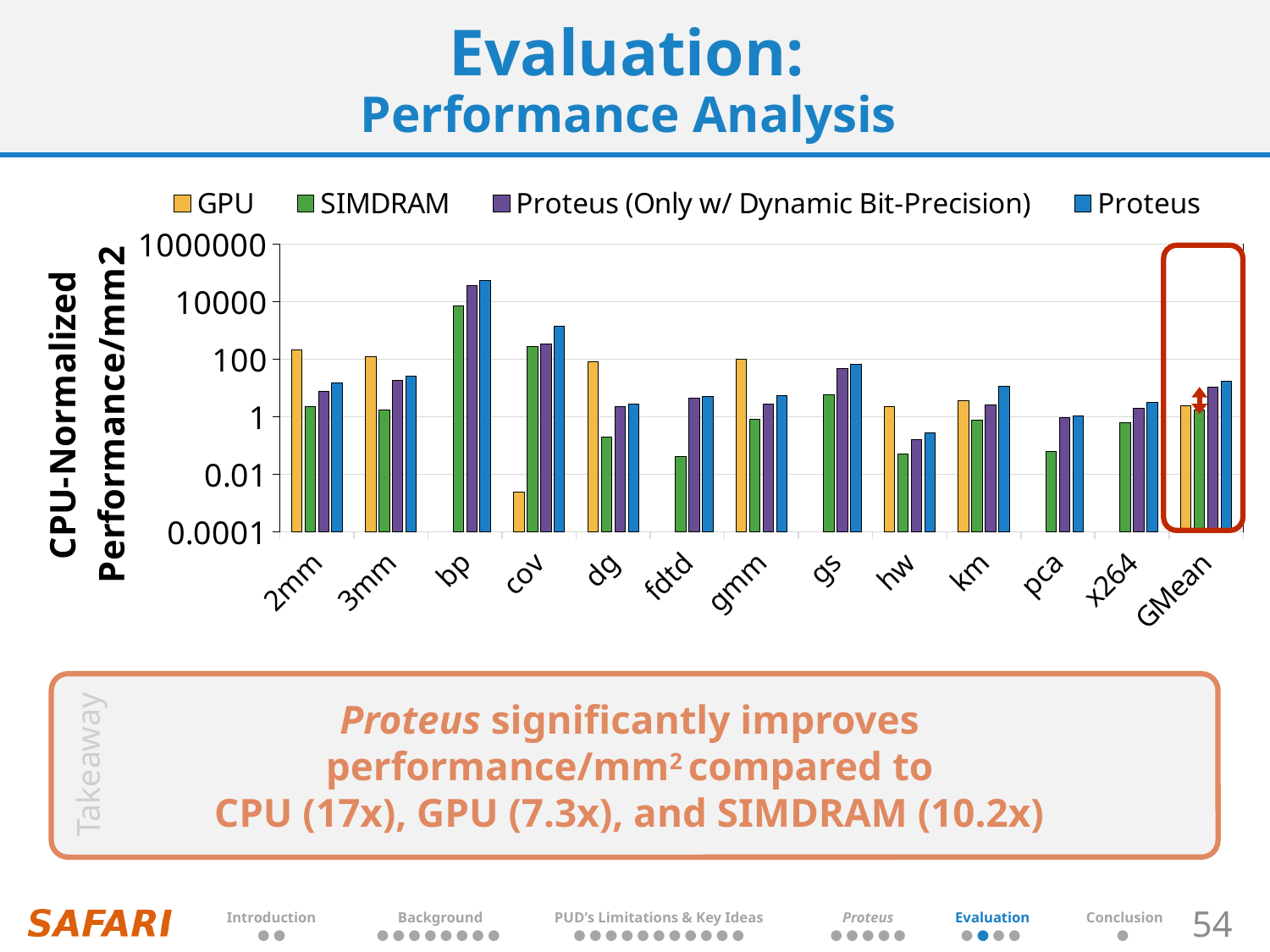
Is the Proteus value for bp greater or less than 10000? greater Which category has the highest Proteus value? bp What kind of chart is shown on the slide? bar chart For cov, which is larger: the Proteus value or the GPU value? Proteus How many categories are shown along the x axis? 13 Which category on the x axis is highlighted with a red box? GMean Is the SIMDRAM value for hw greater or less than 1? less Is the GPU value for 2mm greater or less than 100? greater Which category has the lowest GPU value? cov For 2mm, which is larger: the GPU value or the SIMDRAM value? GPU How many series does the legend list? 4